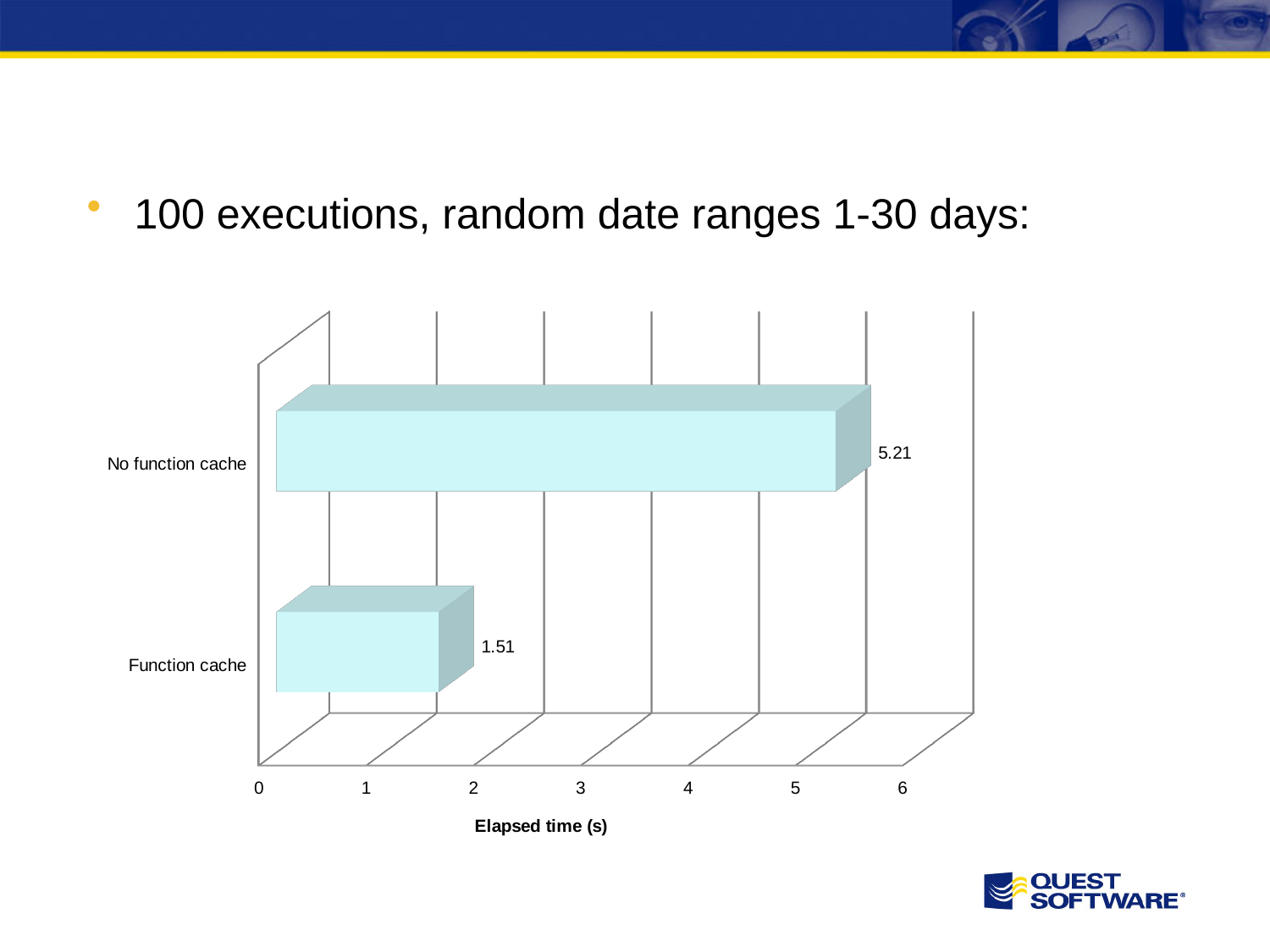
Which category has the lowest elapsed time? Function cache What is the difference in elapsed time between No function cache and Function cache? 3.70 What is the elapsed time for No function cache? 5.21 Is the value for Function cache greater or less than 2? less What kind of chart is shown on the slide? bar chart What is the maximum value shown on the horizontal axis? 6 Which has a larger elapsed time, Function cache or No function cache? No function cache What is the label of the horizontal axis? Elapsed time (s) What is the elapsed time for Function cache? 1.51 How many categories are shown in the chart? 2 Which category has the highest elapsed time? No function cache Is the value for No function cache greater or less than 5? greater